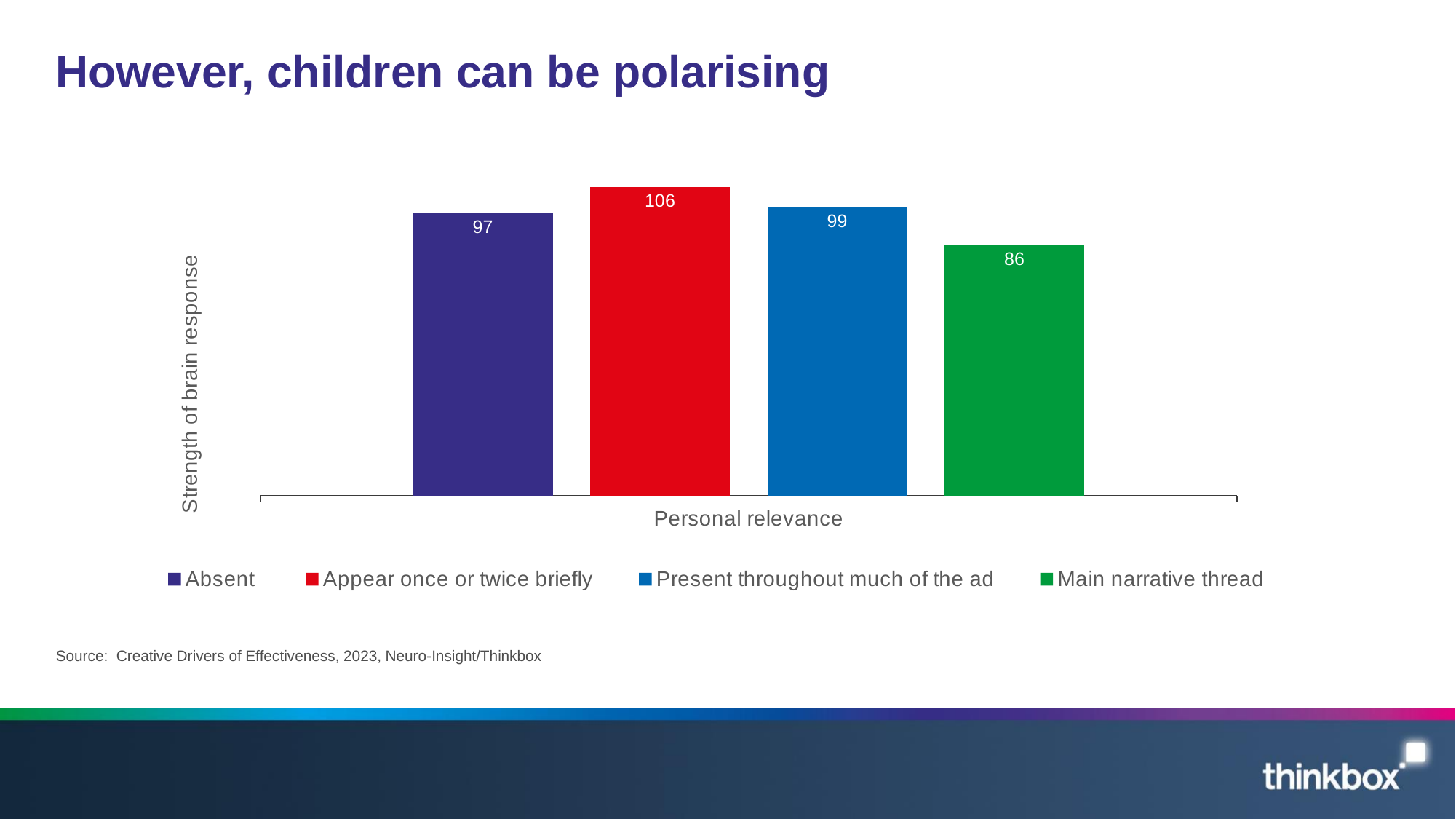
Which series has the lowest value? Main narrative thread What is the value for 'Main narrative thread'? 86 How many series does the legend list? 4 What is the difference between the values for 'Appear once or twice briefly' and 'Main narrative thread'? 20 Which is larger: the value for 'Absent' or the value for 'Main narrative thread'? Absent What is the difference between the values for 'Present throughout much of the ad' and 'Absent'? 2 What is the value for 'Absent' in the Personal relevance chart? 97 What is the label on the vertical axis of the chart? Strength of brain response What kind of chart is shown on the slide? Bar chart What is the value for 'Appear once or twice briefly'? 106 What is the value for 'Present throughout much of the ad'? 99 Which series has the highest value? Appear once or twice briefly